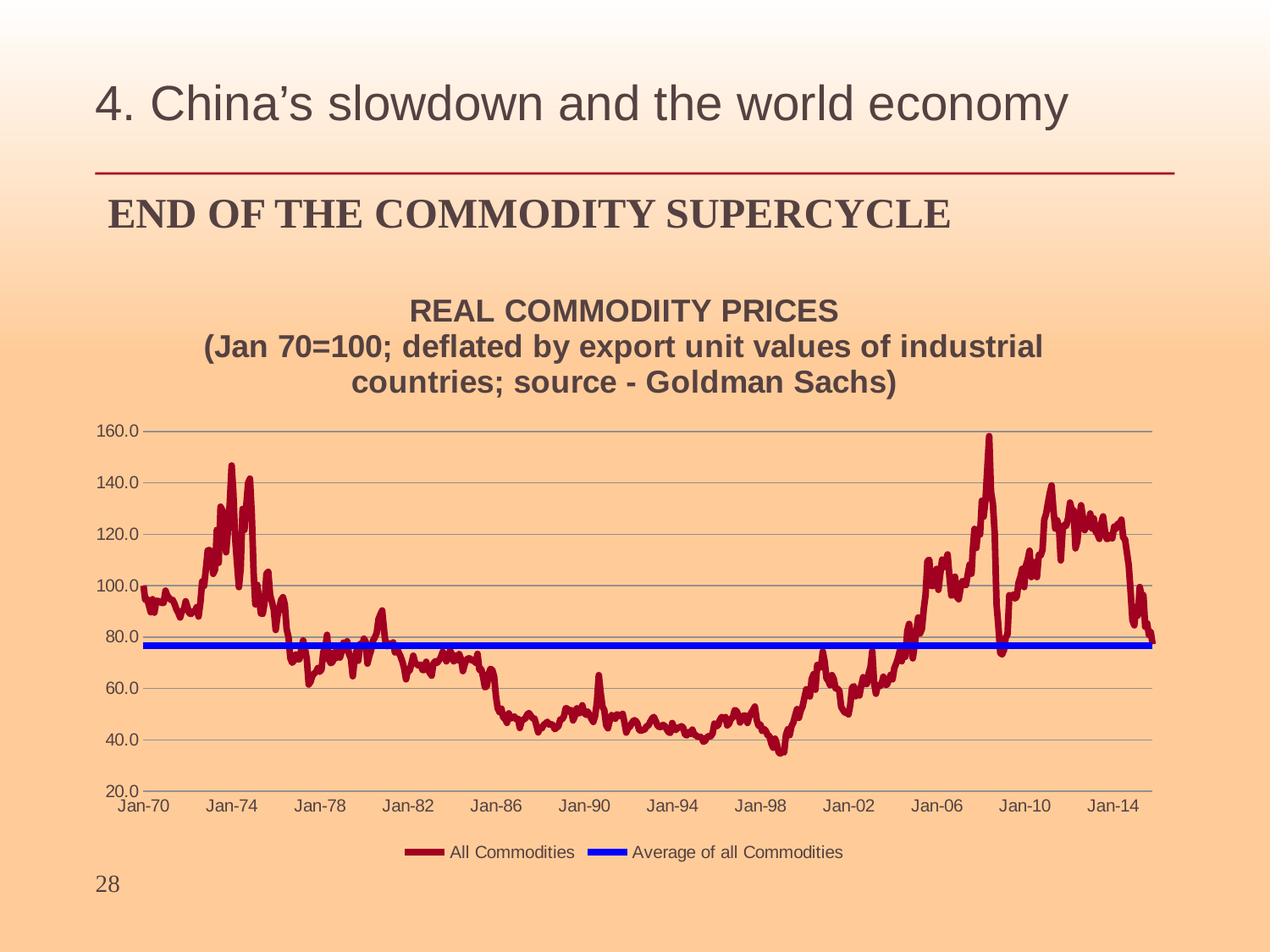
Is the value of All Commodities around Jan-90 greater or less than 60? less Which colour is used for the 'Average of all Commodities' series? Blue How many series does the legend list? 2 Is the 'Average of all Commodities' line greater or less than 60? greater What is the title of the chart? REAL COMMODIITY PRICES (Jan 70=100; deflated by export unit values of industrial countries; source - Goldman Sachs) Is the peak of All Commodities around 2008 greater or less than 140? greater Which peak of All Commodities is higher: the one around 1974 or the one around 2008? around 2008 What is the highest value shown on the y axis? 160.0 What kind of chart is shown on the slide? Line chart How many year labels are shown on the x axis? 12 Does the All Commodities series rise or fall between Jan-98 and Jan-06? rise